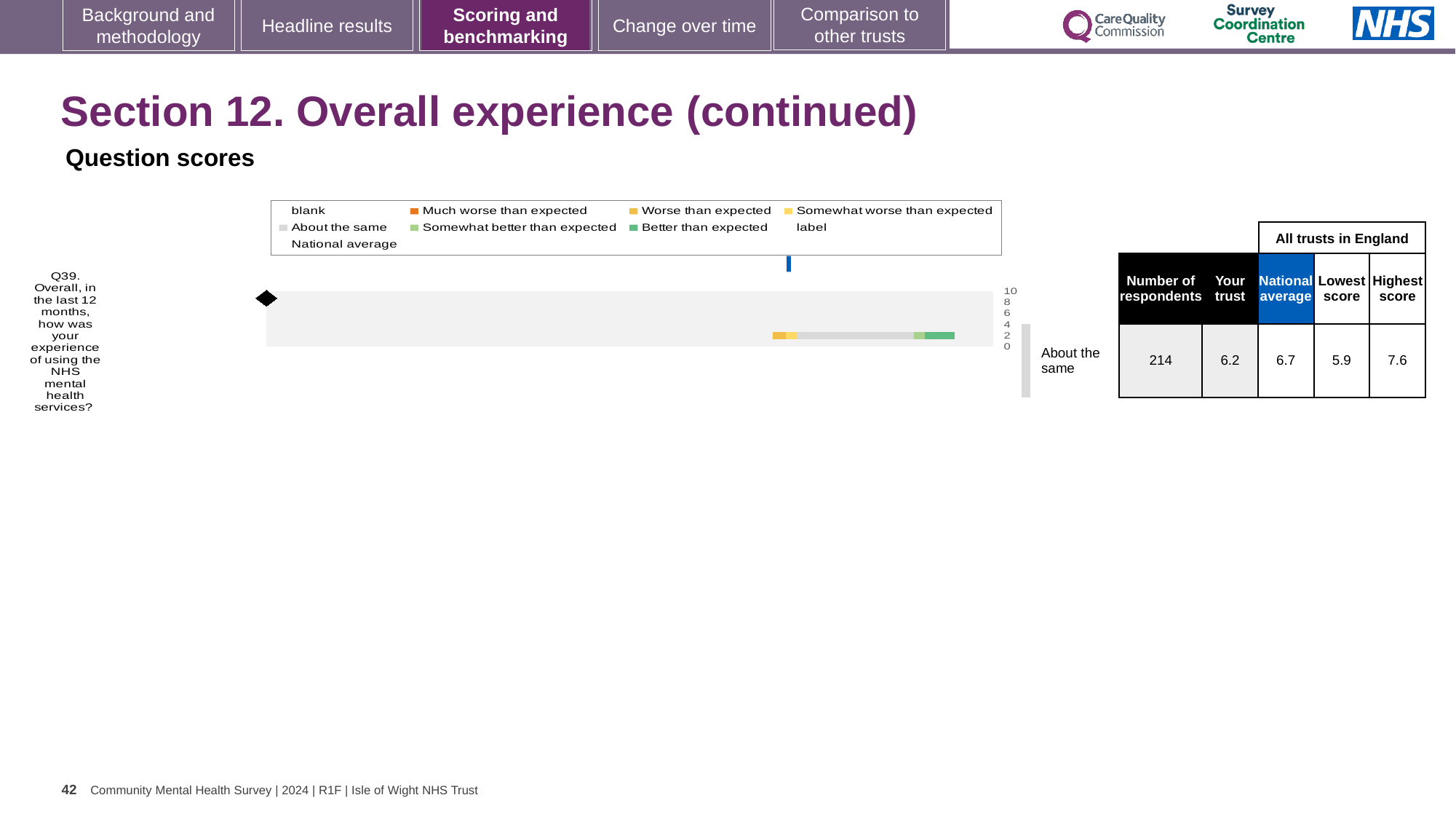
What is the highest score among all trusts in England for Q39? 7.6 How many entries does the chart legend list? 9 What is the 'Your trust' score for Q39 in the table next to the chart? 6.2 How many respondents answered Q39? 214 How many survey questions are plotted in the chart? 1 What is the difference between the highest and lowest scores for Q39 across all trusts in England? 1.7 What is the difference between the national average and the trust's score for Q39? 0.5 What benchmark category label is shown for Q39 to the right of the chart? About the same What is the national average score for Q39 shown in the table? 6.7 What is the lowest score among all trusts in England for Q39? 5.9 Which is larger for Q39: the trust's score or the national average? national average What kind of chart is shown on the slide? bar chart